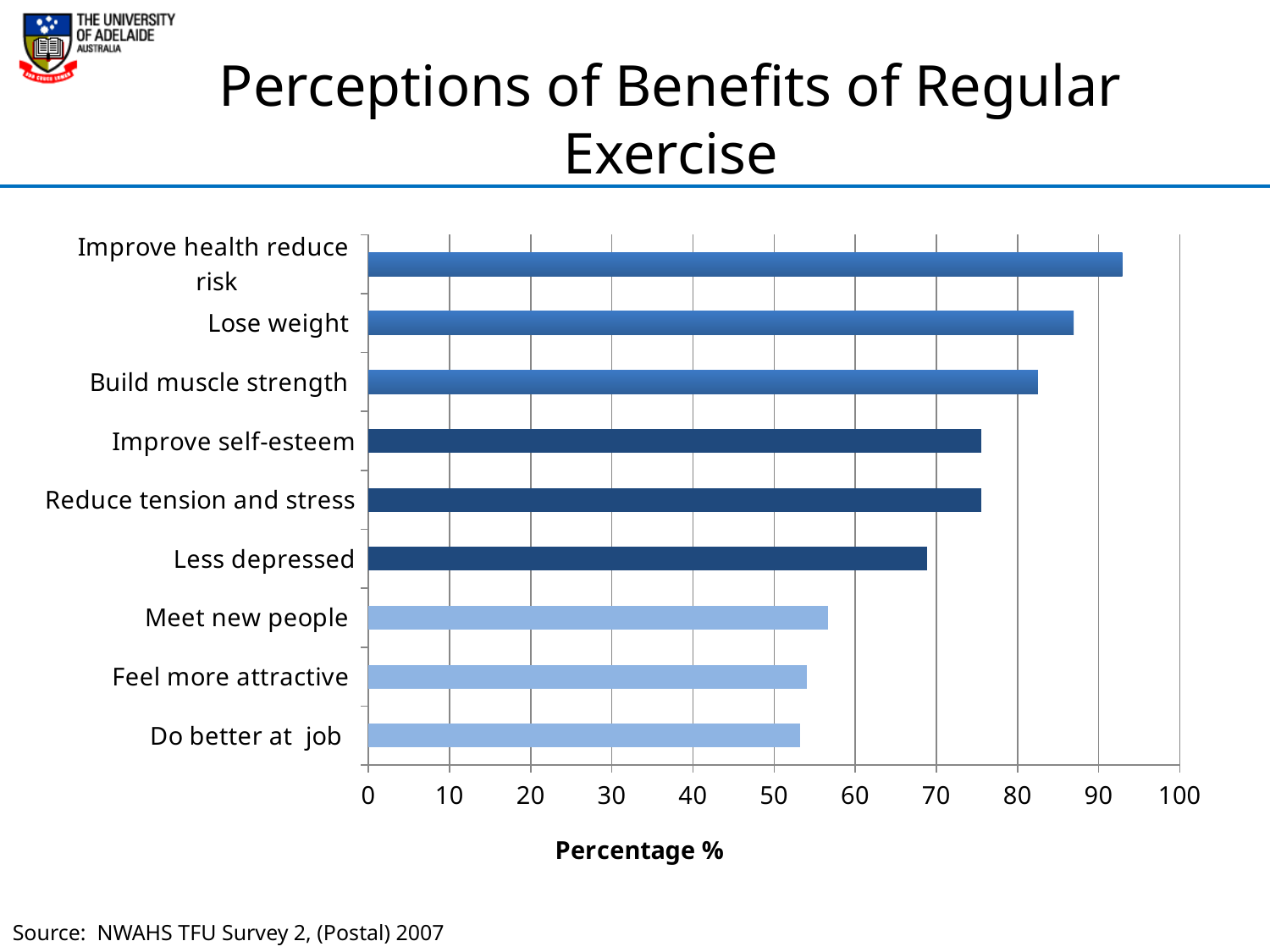
Is the value for Meet new people greater or less than 60? less What kind of chart is shown on the slide? bar chart Is the value for Lose weight greater or less than 80? greater Which benefit has the highest percentage in the chart? Improve health reduce risk Is the value for Improve health reduce risk greater or less than 90? greater Which is larger, the value for Lose weight or the value for Less depressed? Lose weight What is the label on the horizontal axis of the chart? Percentage % Which is larger, the value for Meet new people or the value for Build muscle strength? Build muscle strength How many benefit categories are plotted in the chart? 9